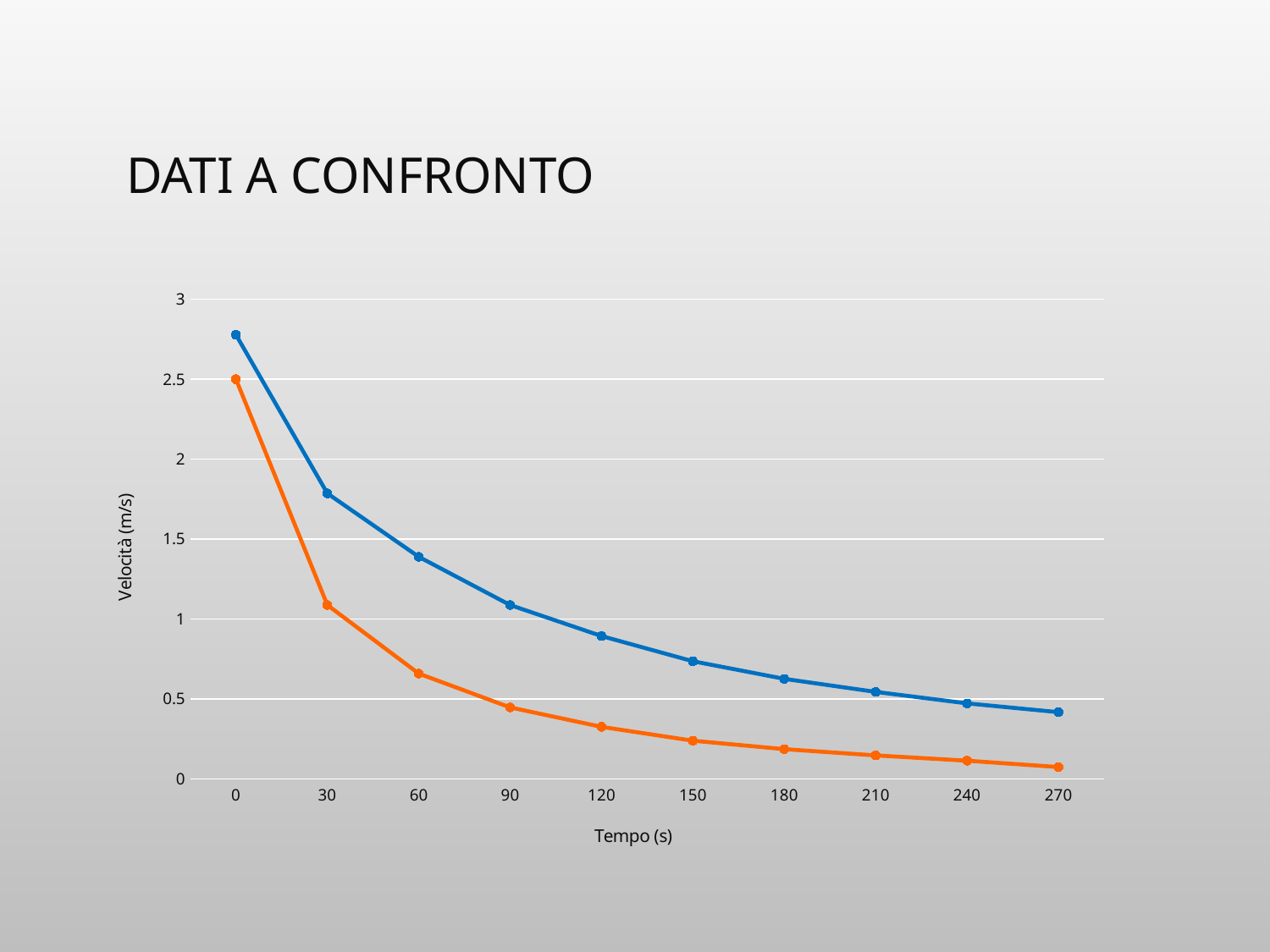
Is the value of the orange line at time 60 greater or less than 1? less At time 60, which line has the higher value, the blue line or the orange line? the blue line Is the value of the blue line at time 270 greater or less than 0.5? less Is the value of the orange line at time 90 greater or less than 0.5? less What is the label of the vertical axis? Velocità (m/s) How many data points does each line have? 10 How many lines are plotted on the chart? 2 What kind of chart is shown on the slide? line chart Do the values of the blue line rise or fall as time increases along the x axis? fall What is the title of the chart? DATI A CONFRONTO